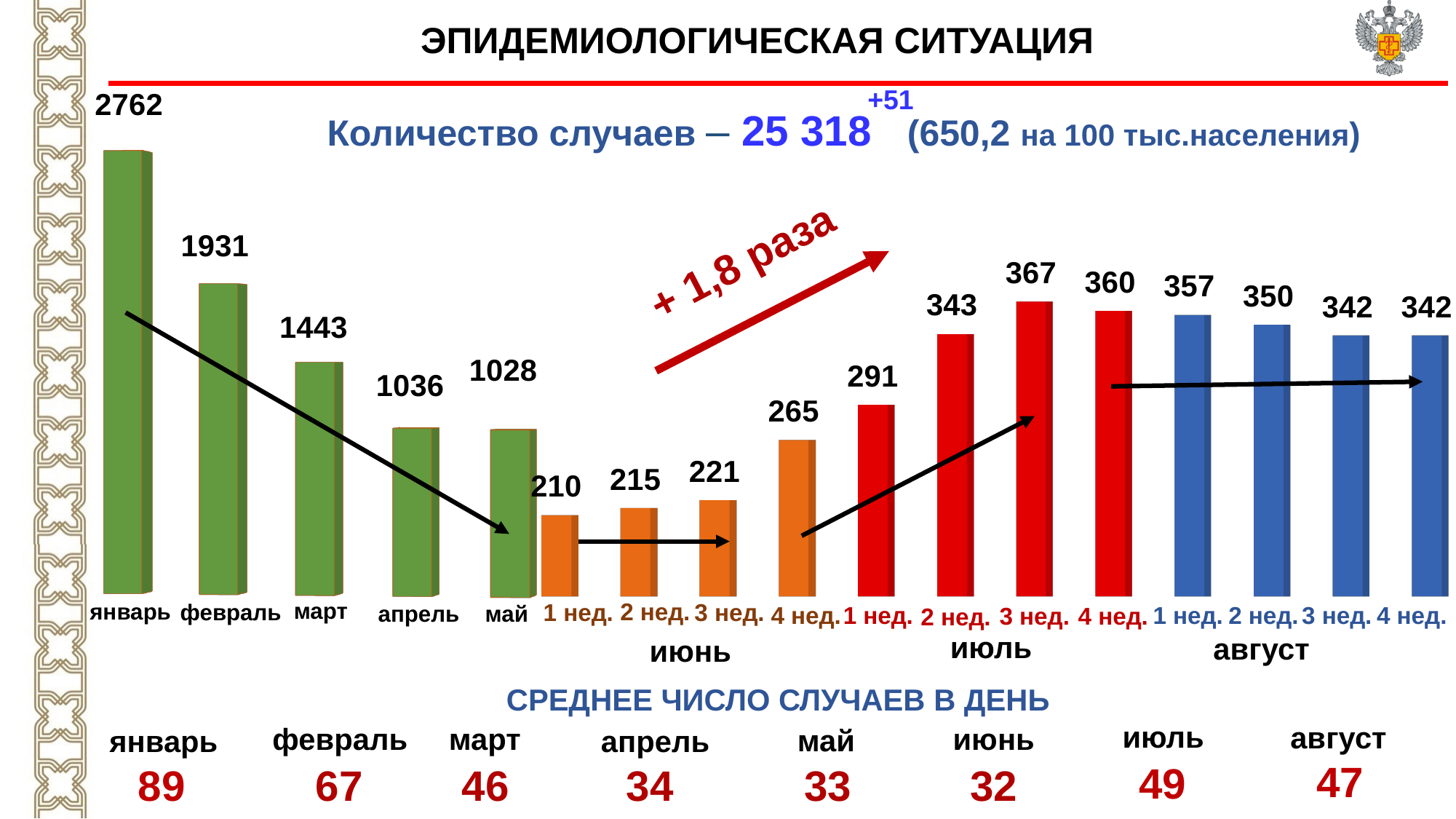
Do the values rise or fall from январь to май? fall What is the value of the bar for 4 нед. (week 4) of июнь (June)? 265 How many bars are plotted in the chart? 17 Do the values rise or fall across the four weeks of июнь? rise What is the value of the bar for январь (January)? 2762 Which bar has the lowest value? 1 нед. июнь What is the difference between the values for январь and февраль? 831 Which is larger, the value for апрель or the value for май? апрель What is the difference between the values for 3 нед. and 1 нед. of июль? 76 What is the value of the bar for 3 нед. (week 3) of июль (July)? 367 What kind of chart is shown on the slide? bar chart Which bar has the highest value? январь